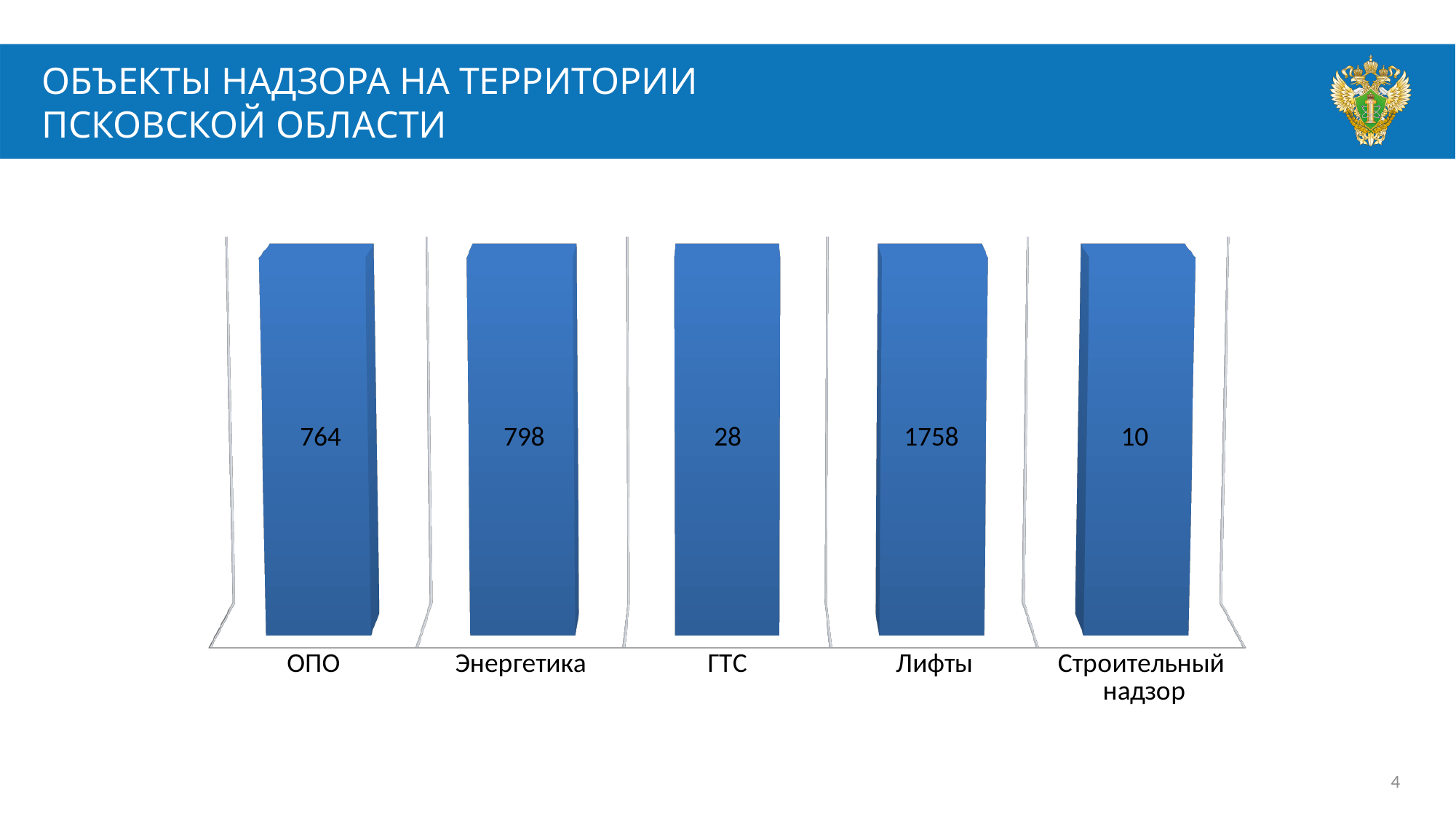
What is the difference between the values for Лифты and ГТС? 1730 Which has a larger value, ОПО or Энергетика? Энергетика How many categories are shown in the chart? 5 Which category has the highest value according to the data labels? Лифты What value is shown for ОПО? 764 Which category has the lowest value according to the data labels? Строительный надзор What is the difference between the values for Энергетика and ОПО? 34 What kind of chart is shown on the slide? Bar chart What value is shown for Энергетика? 798 What value is shown for Строительный надзор? 10 What value is shown for ГТС? 28 What value is shown for Лифты? 1758